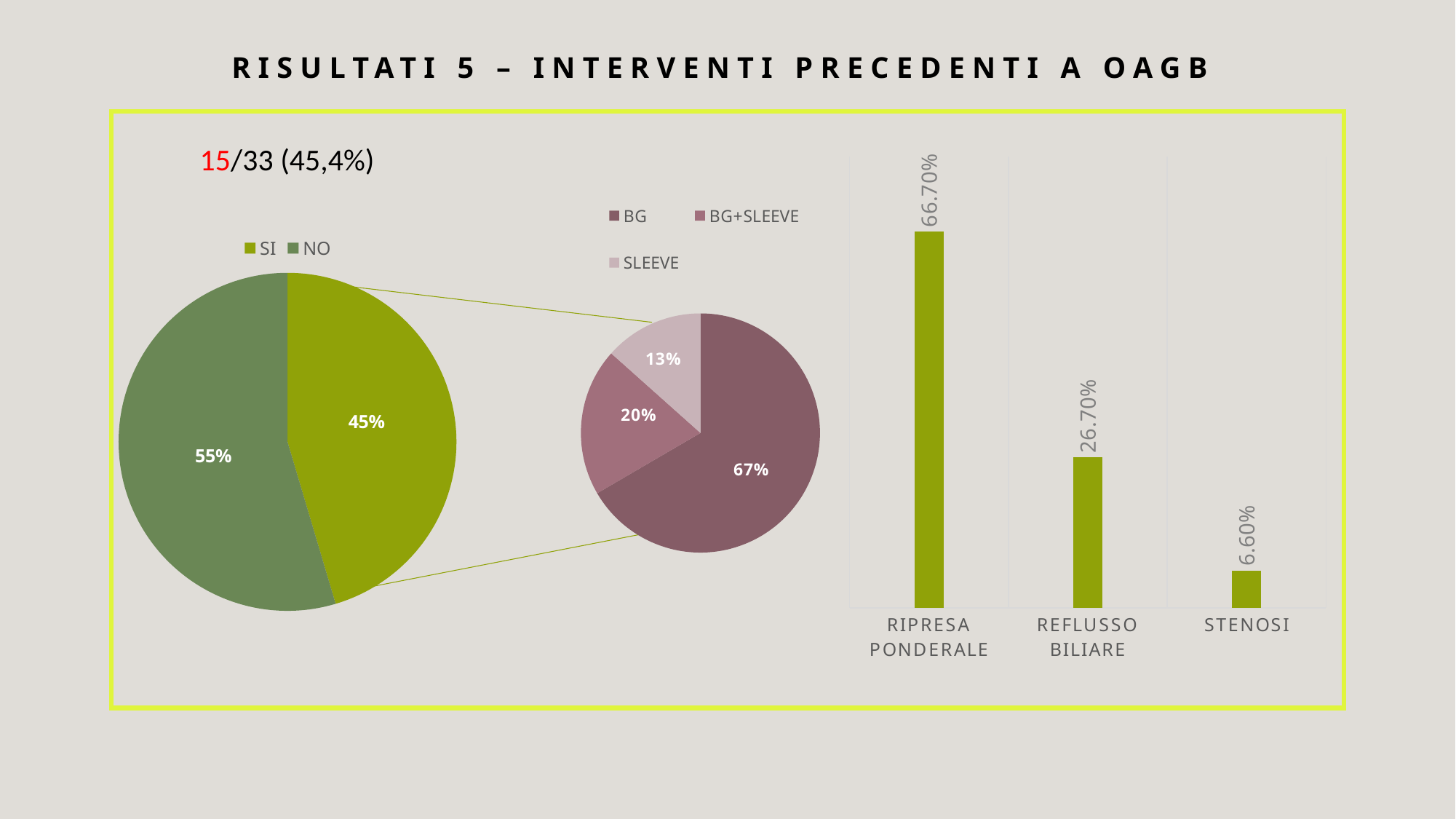
In the middle pie chart, how many categories does the legend list? 3 In the middle pie chart (BG / BG+SLEEVE / SLEEVE), which category has the smallest slice? SLEEVE In the middle pie chart (BG / BG+SLEEVE / SLEEVE), what share does the BG slice have? 67% In the bar chart on the right, what is the difference between RIPRESA PONDERALE and STENOSI? 60.10% In the bar chart on the right, which category has the lowest value? STENOSI In the left pie chart (SI/NO), what share does the NO slice have? 55% In the middle pie chart (BG / BG+SLEEVE / SLEEVE), what is the difference between the BG and BG+SLEEVE shares? 47% In the left pie chart (SI/NO), which slice is larger, SI or NO? NO In the bar chart on the right, what is the value for RIFLUSSO BILIARE? 26.70% In the left pie chart (SI/NO), what share does the SI slice have? 45% What kind of chart is the chart on the right of the slide? Bar chart In the middle pie chart (BG / BG+SLEEVE / SLEEVE), what share does the SLEEVE slice have? 13%